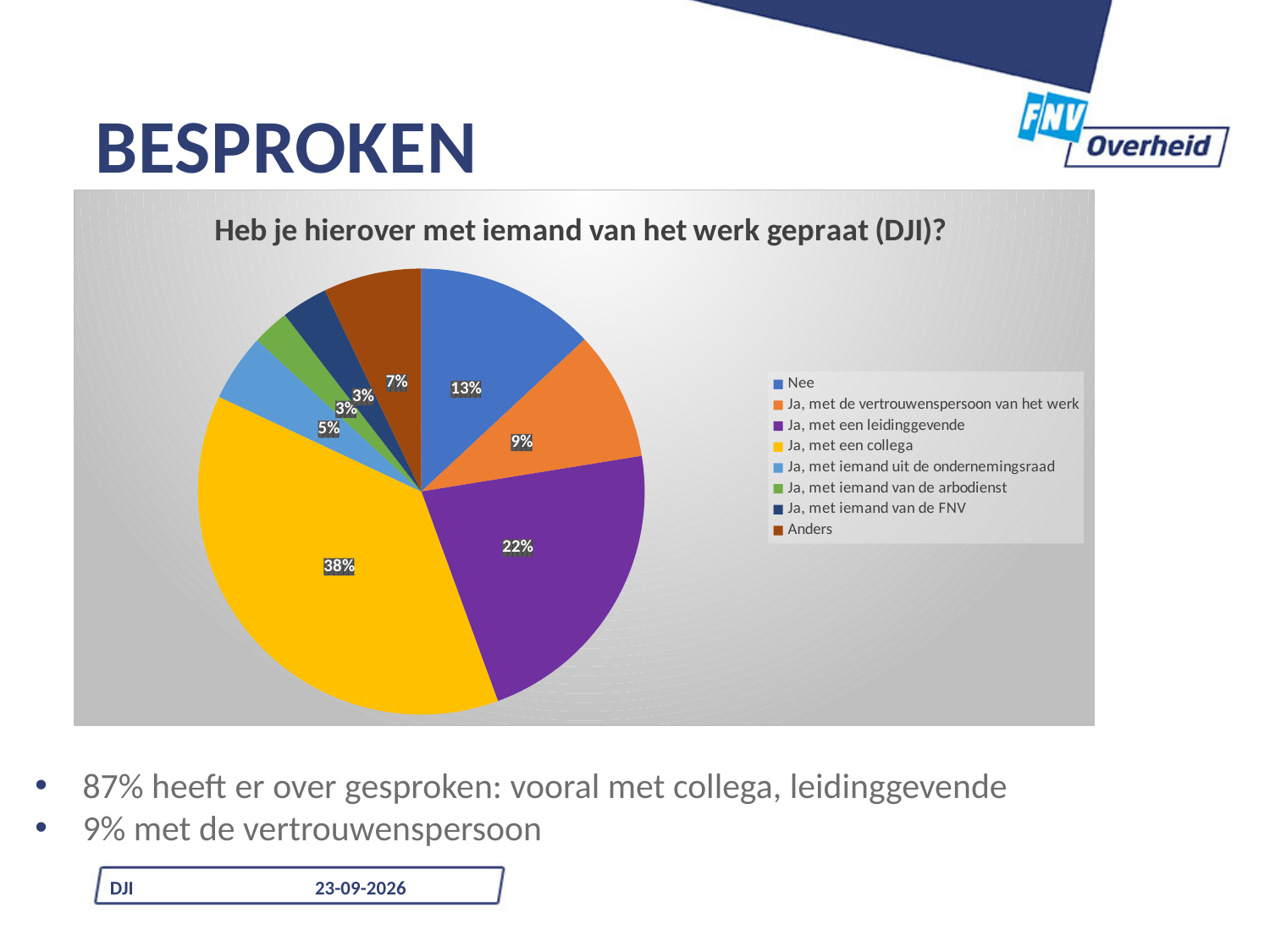
Which category has the largest slice of the pie? Ja, met een collega What percentage of the pie is 'Nee'? 13% What type of chart is shown on the slide? pie chart What percentage of the pie is 'Ja, met een leidinggevende'? 22% Which is larger: the slice for 'Nee' or the slice for 'Ja, met de vertrouwenspersoon van het werk'? Nee What colour is the slice for 'Ja, met een collega'? yellow What is the title of the chart? Heb je hierover met iemand van het werk gepraat (DJI)? What percentage of the pie is 'Ja, met een collega'? 38% What percentage of the pie is 'Anders'? 7% What percentage of the pie is 'Ja, met de vertrouwenspersoon van het werk'? 9% How many categories does the legend list? 8 What is the difference in percentage points between 'Ja, met een collega' and 'Ja, met een leidinggevende'? 16